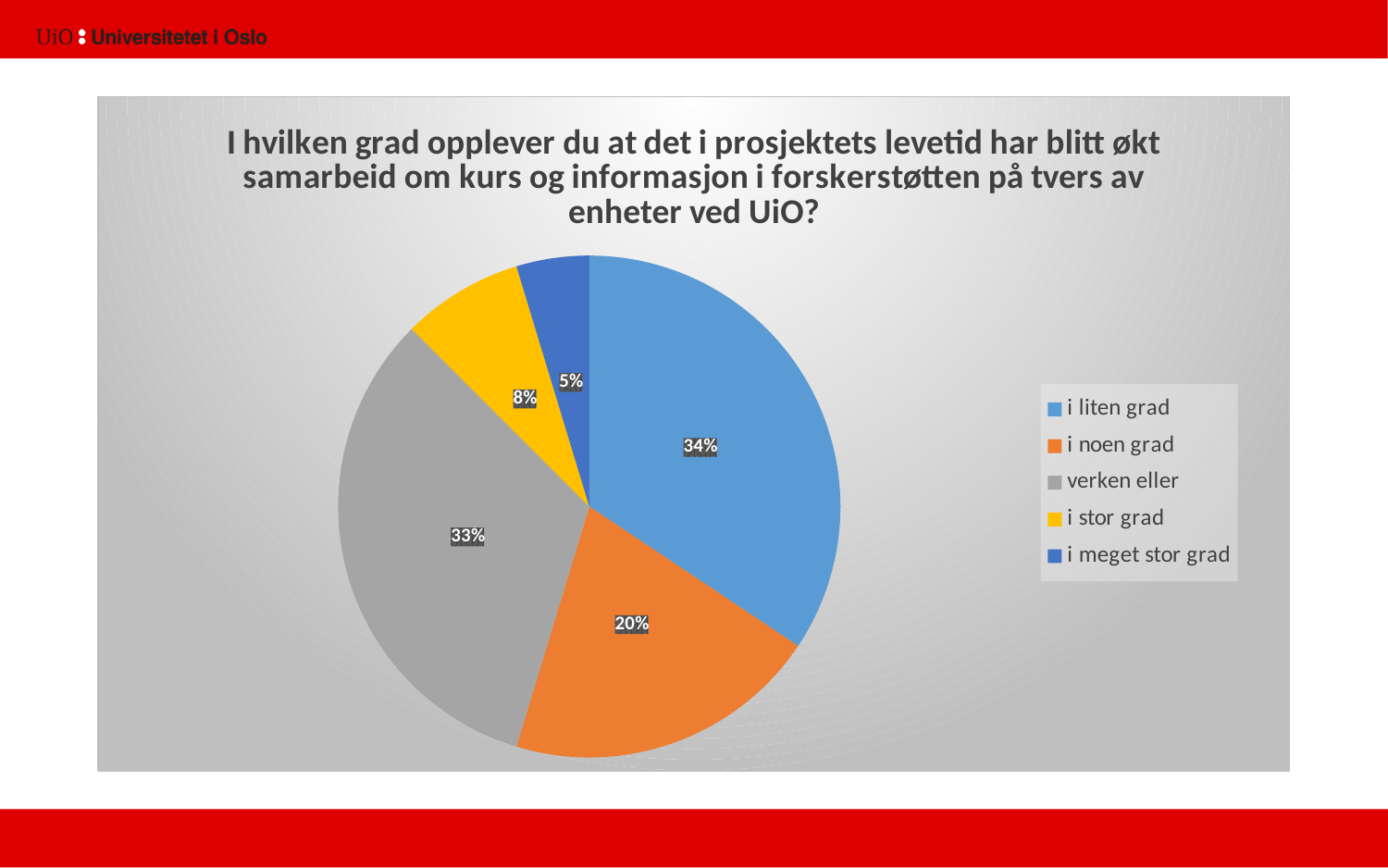
What share of the pie does "i stor grad" have? 8% What kind of chart is shown on the slide? pie chart Which category has the smallest slice of the pie? i meget stor grad What share of the pie does "verken eller" have? 33% How many categories does the legend list? 5 What share of the pie does "i meget stor grad" have? 5% What colour is the slice for "i stor grad"? yellow Which is larger, the share for "i noen grad" or the share for "i meget stor grad"? i noen grad What is the combined share of "i stor grad" and "i meget stor grad"? 13% What is the difference in percentage points between "i noen grad" and "i stor grad"? 12